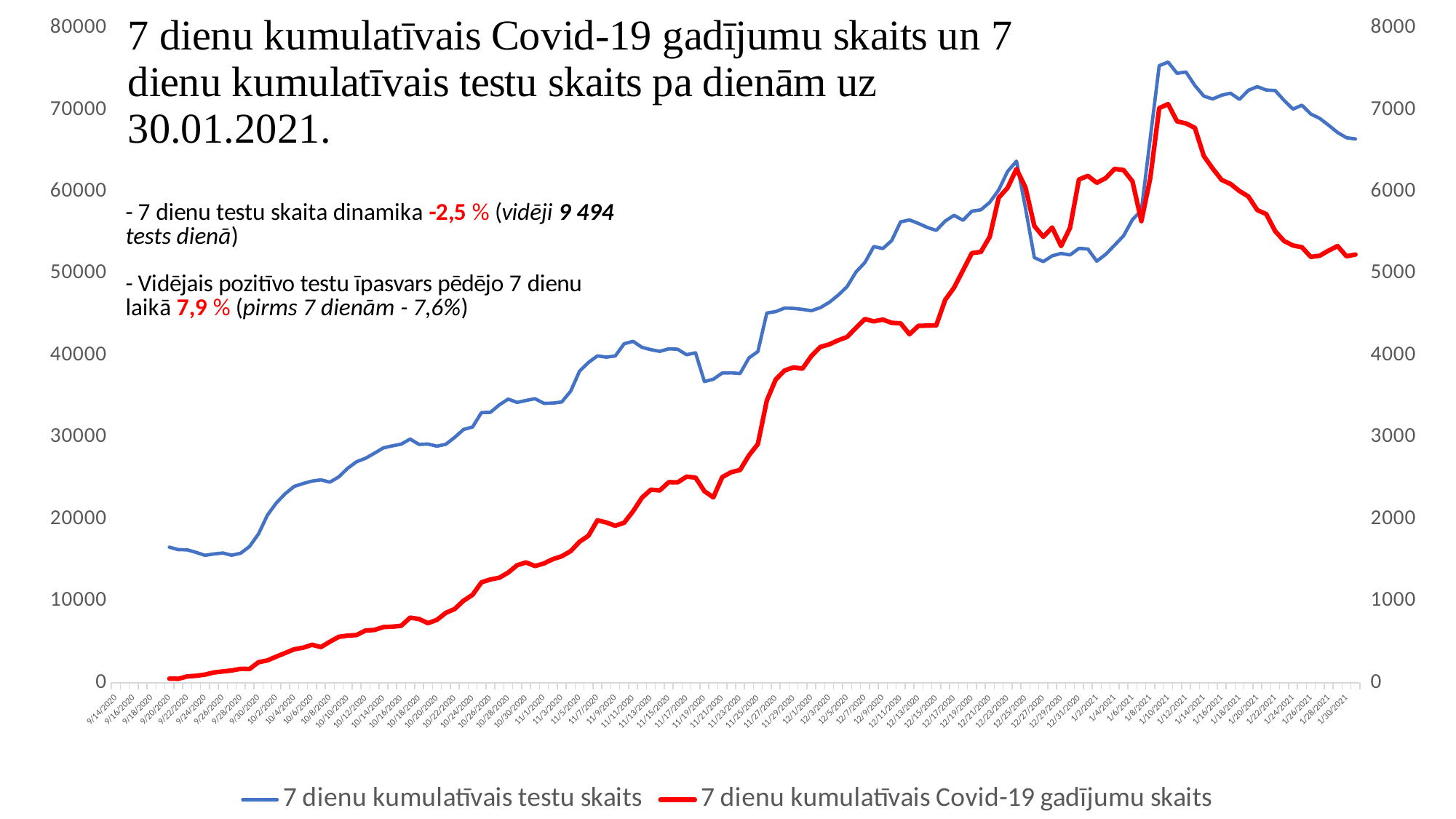
What kind of chart is shown on the slide? line chart What is the highest value shown on the left vertical axis? 80000 Is the value of the blue line (7 dienu kumulatīvais testu skaits) at 11/1/2020 greater or less than 30000? greater Is the value of the red line (7 dienu kumulatīvais Covid-19 gadījumu skaits) at 9/20/2020 greater or less than 1000 on the right axis? less Does the red line (7 dienu kumulatīvais Covid-19 gadījumu skaits) rise or fall between 9/20/2020 and 1/8/2021? rise Around which date does the blue line (7 dienu kumulatīvais testu skaits) reach its highest value? 1/10/2021 Is the value of the red line (7 dienu kumulatīvais Covid-19 gadījumu skaits) at 1/30/2021 greater or less than 5000 on the right axis? greater Is the value of the blue line (7 dienu kumulatīvais testu skaits) larger at 1/8/2021 or at 12/25/2020? 1/8/2021 Which series is drawn in red? 7 dienu kumulatīvais Covid-19 gadījumu skaits How many series does the legend list? 2